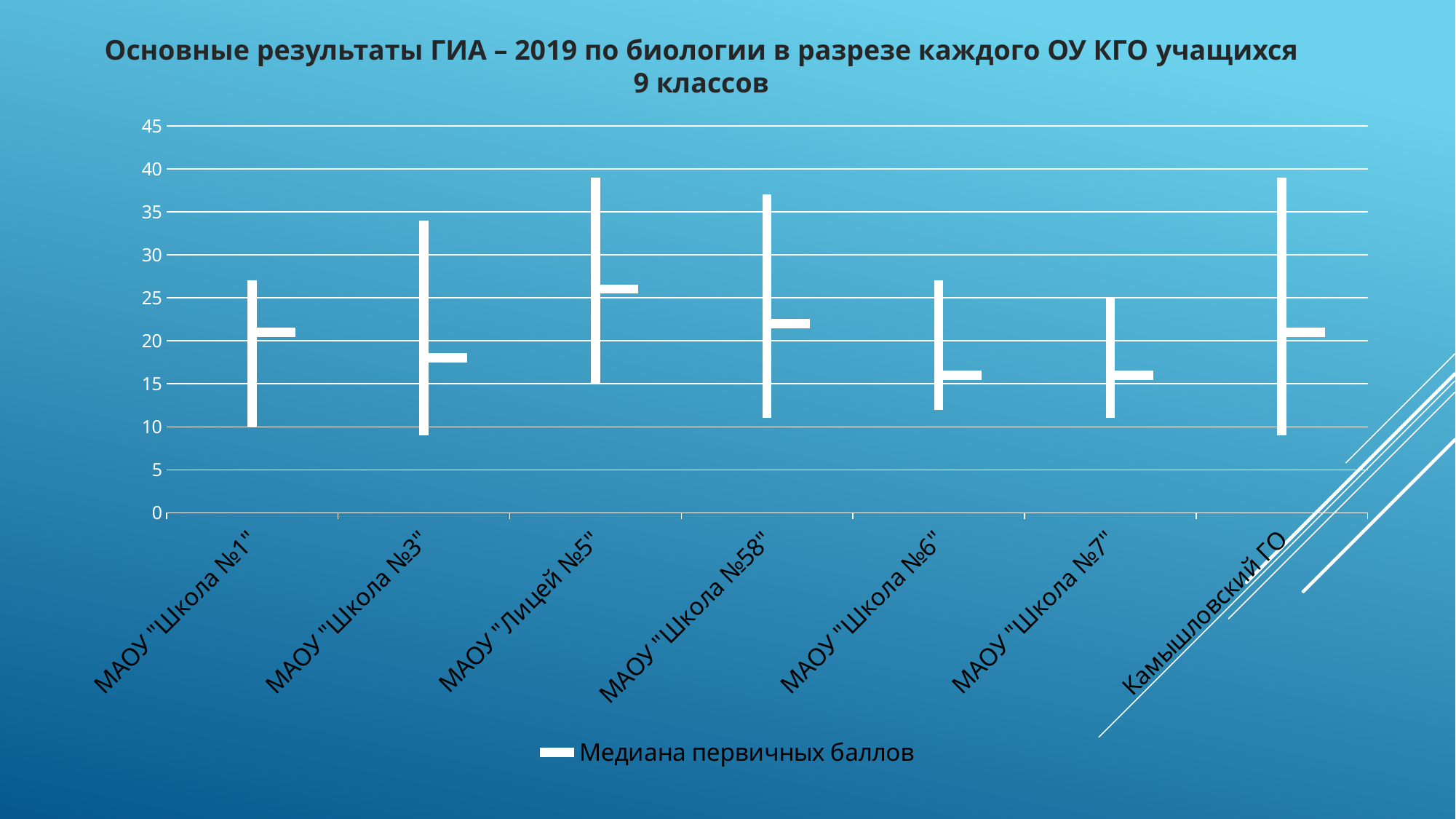
Is the bottom of the score range for МАОУ "Школа №7" greater or less than 15? less Is the median primary score for МАОУ "Школа №3" greater or less than 20? less How many schools (categories) are shown on the x axis of the chart? 7 Which school has the highest median primary score (Медиана первичных баллов)? МАОУ "Лицей №5" Is the median primary score for МАОУ "Лицей №5" greater or less than 20? greater Which has the larger median primary score: МАОУ "Лицей №5" or МАОУ "Школа №3"? МАОУ "Лицей №5" What is the title of the chart? Основные результаты ГИА – 2019 по биологии в разрезе каждого ОУ КГО учащихся 9 классов Which has the larger median primary score: МАОУ "Школа №58" or МАОУ "Школа №6"? МАОУ "Школа №58" What is the name of the series shown in the chart legend? Медиана первичных баллов How many series does the chart legend list? 1